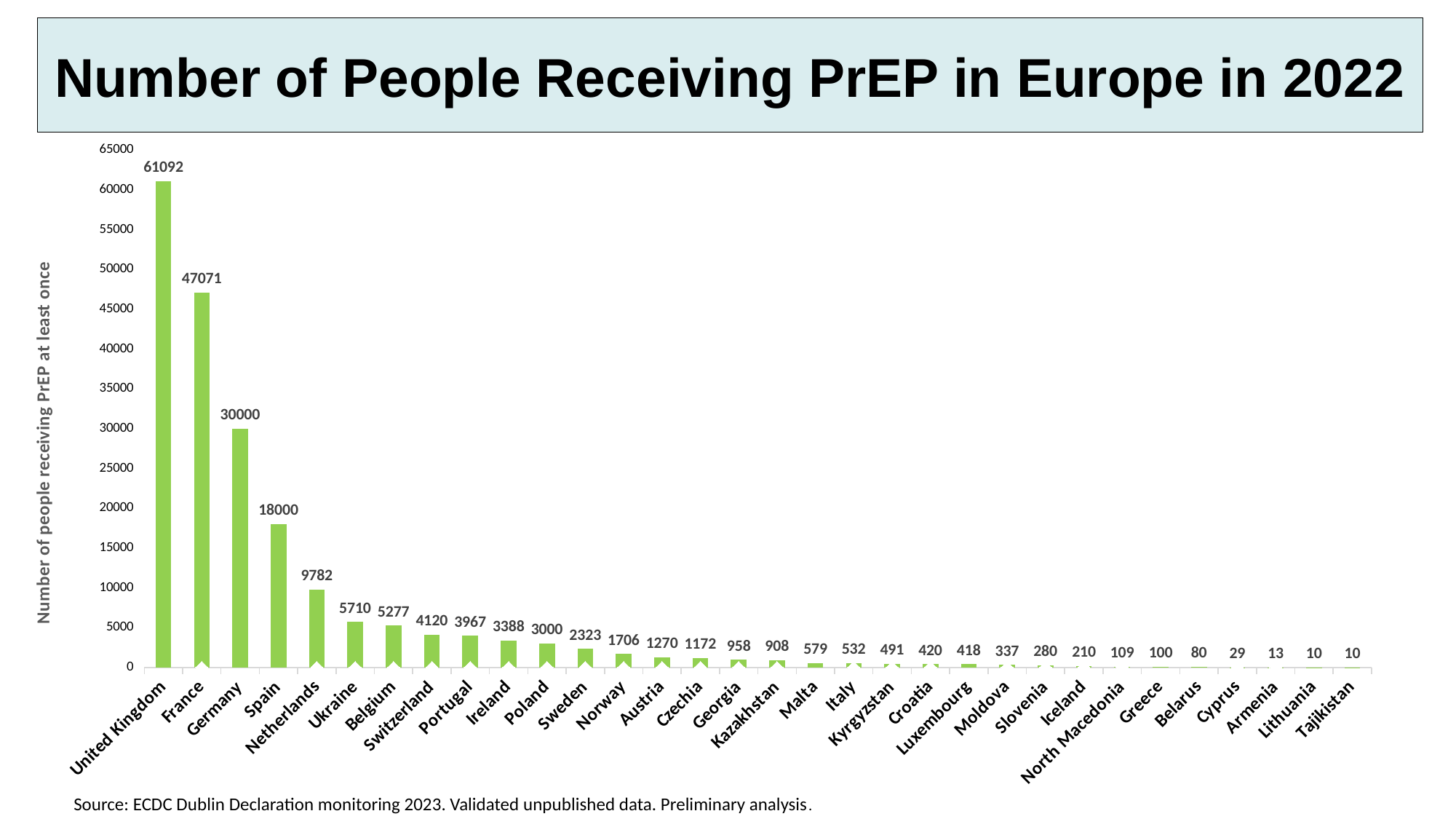
Which has a larger value, Belgium or Ukraine? Ukraine Is the value for Germany greater or less than 25000? greater What type of chart is shown on the slide? bar chart What is the value shown for the Netherlands? 9782 What is the difference between the values for Germany and Spain? 12000 What is the label of the vertical axis? Number of people receiving PrEP at least once Do the values rise or fall moving from left to right along the x axis? fall How many countries are shown on the chart? 32 What is the value shown for Kazakhstan? 908 What is the difference between the values for the United Kingdom and France? 14021 Which country has the highest number of people receiving PrEP? United Kingdom How many people received PrEP in France in 2022? 47071